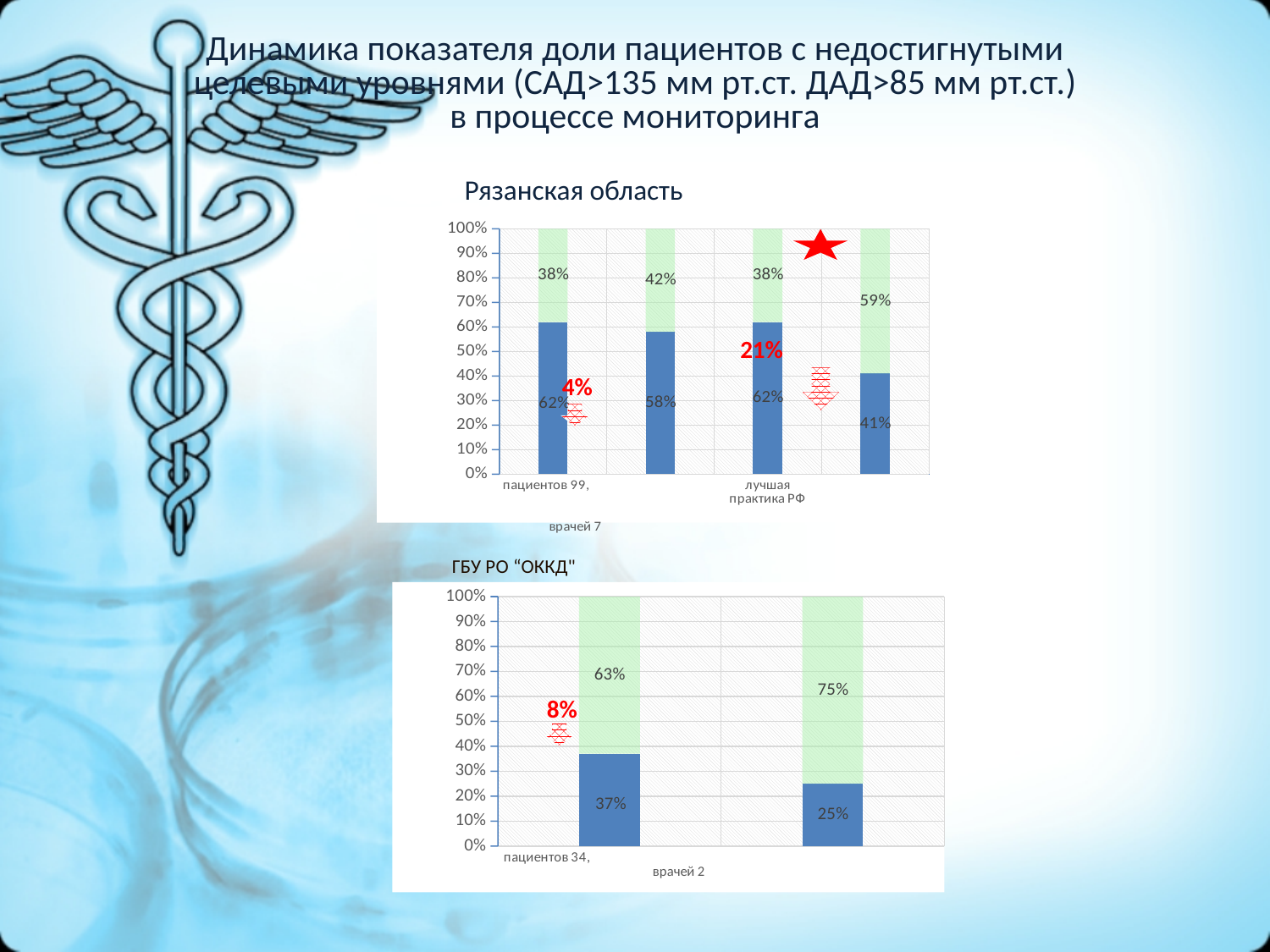
How many bars are plotted in the "Рязанская область" chart? 4 In the "ГБУ РО "ОККД"" chart, what is the green segment value of the second bar? 75% In the "ГБУ РО "ОККД"" chart, which bar has the larger blue segment, the first or the second? the first In the "ГБУ РО "ОККД"" chart, what is the difference between the blue segments of the first bar (37%) and the second bar (25%)? 12% In the "Рязанская область" chart, what is the blue segment value of the fourth (rightmost) bar? 41% What kind of chart is the "Рязанская область" chart? stacked bar chart In the "Рязанская область" chart, what is the blue segment value of the first bar? 62% In the "ГБУ РО "ОККД"" chart, what is the blue segment value of the first bar? 37% How many bars are plotted in the "ГБУ РО "ОККД"" chart? 2 In the "Рязанская область" chart, what is the green segment value of the rightmost bar? 59% In the "Рязанская область" chart, what is the green segment value of the second bar? 42% In the "Рязанская область" chart, what is the difference between the blue segment of the first bar (62%) and the blue segment of the second bar (58%)? 4%